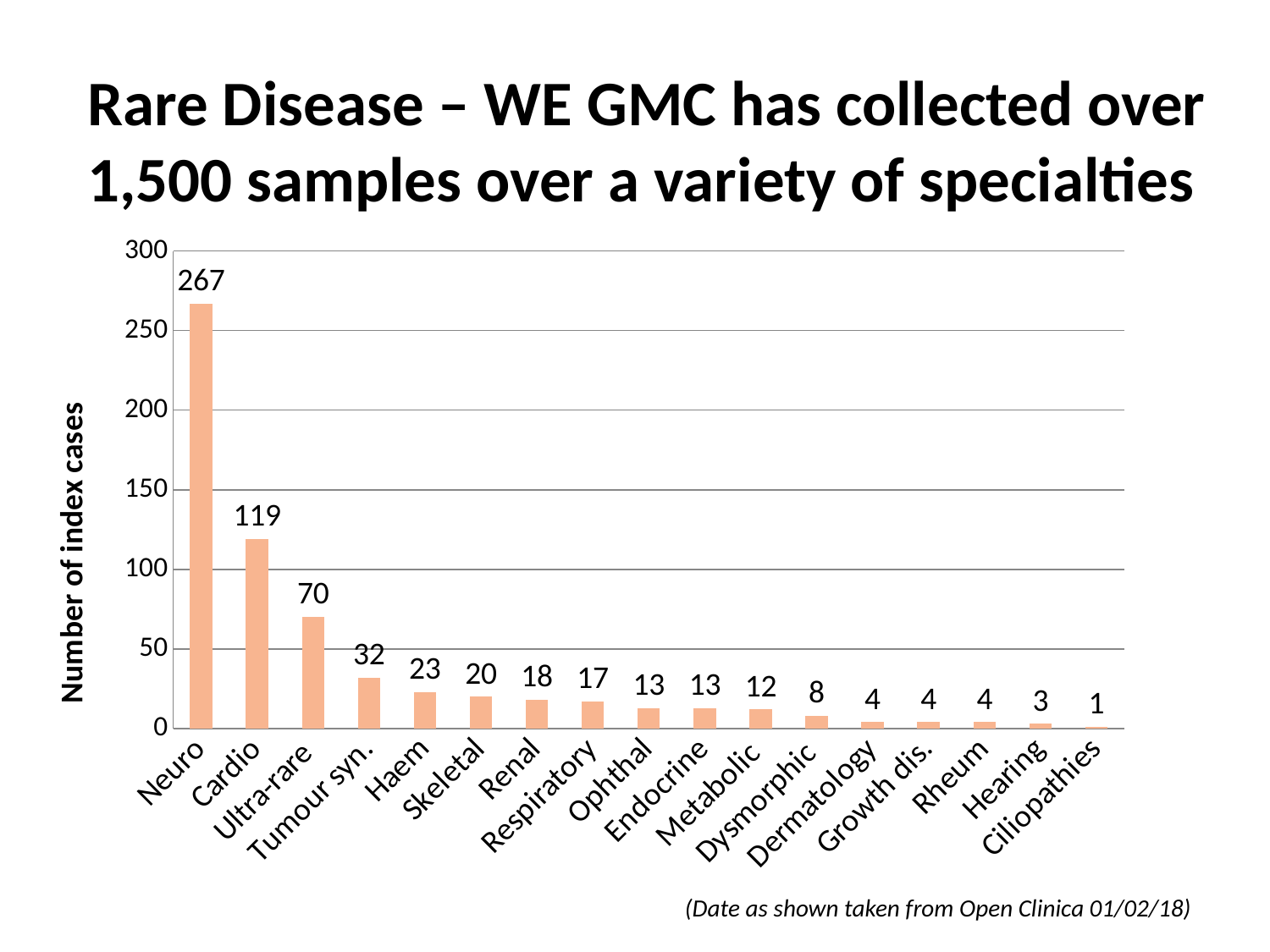
How many specialties are shown on the x axis? 17 What is the number of index cases for Metabolic? 12 What is the number of index cases for Neuro? 267 What is the difference in index cases between Neuro and Cardio? 148 What is the label of the vertical axis? Number of index cases What type of chart is shown on the slide? Bar chart Which specialty has the highest number of index cases? Neuro Which specialty has the lowest number of index cases? Ciliopathies Which has more index cases, Skeletal or Renal? Skeletal What is the number of index cases for Tumour syn.? 32 What is the difference in index cases between Ultra-rare and Haem? 47 What is the number of index cases for Cardio? 119